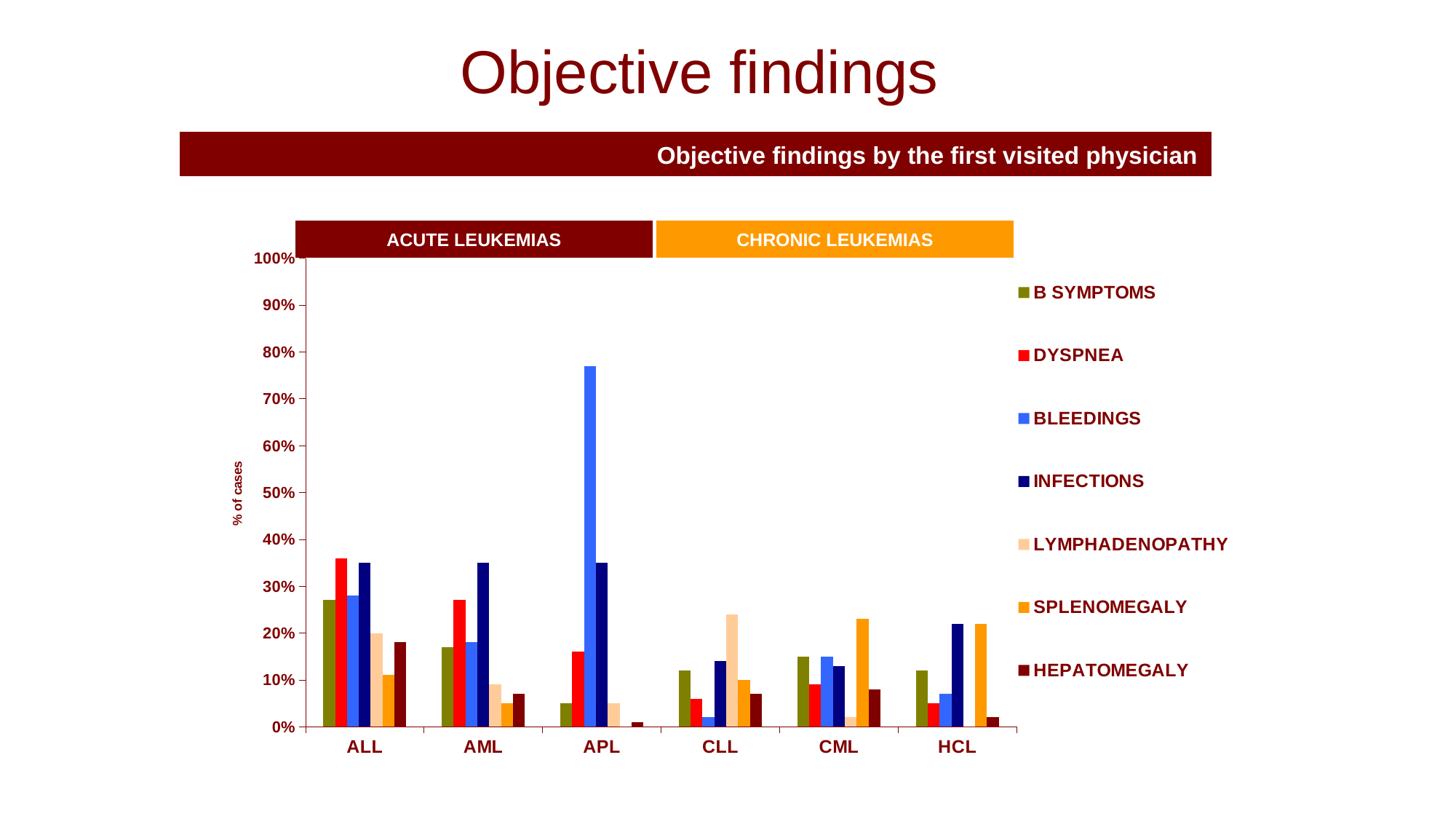
Is the INFECTIONS value for AML greater or less than 30%? greater How many series does the legend list? 7 How many leukemia categories are shown on the x axis? 6 Which category has the highest BLEEDINGS bar? APL For CML, which is larger: SPLENOMEGALY or HEPATOMEGALY? SPLENOMEGALY What is the label of the y axis? % of cases Which categories are grouped under the CHRONIC LEUKEMIAS heading? CLL, CML, HCL Is the BLEEDINGS value for APL greater or less than 70%? greater Is the LYMPHADENOPATHY value for CLL greater or less than 20%? greater Which category has the lowest BLEEDINGS bar? CLL For CLL, which is larger: LYMPHADENOPATHY or B SYMPTOMS? LYMPHADENOPATHY What kind of chart is shown on the slide? bar chart